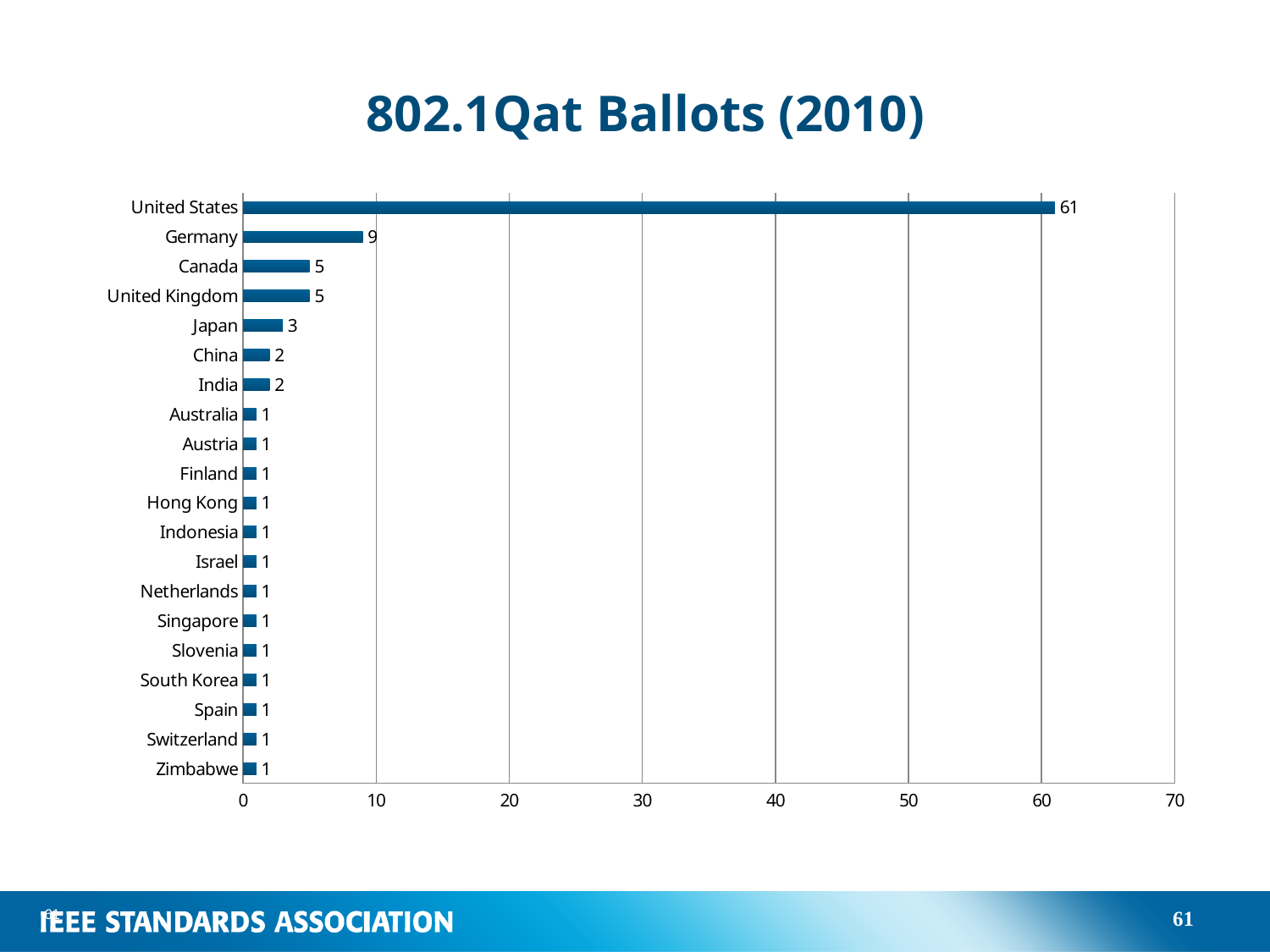
Which is larger, the value for Japan or the value for China? Japan Which country has the highest value? United States What kind of chart is shown on the slide? bar chart Is the value for Germany greater or less than 10? less What is the value for Japan? 3 What is the value for Germany? 9 Is the value for the United States greater or less than 60? greater What is the difference between the values for Germany and Canada? 4 What is the value for the United States? 61 What is the difference between the values for the United States and Germany? 52 How many countries are shown in the chart? 20 What is the title of the chart? 802.1Qat Ballots (2010)